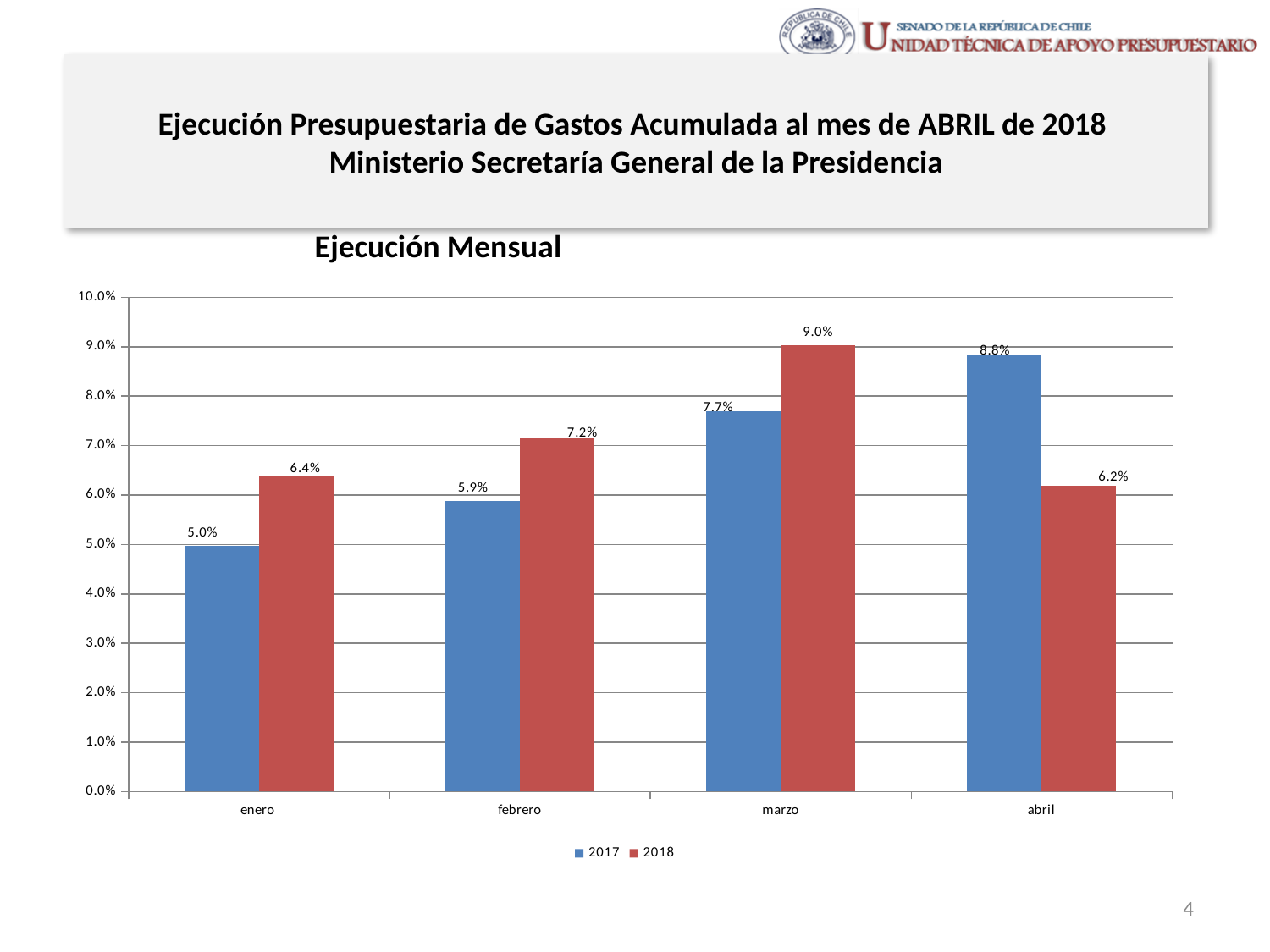
In which month is the 2017 value highest? abril What is the value for 2018 in abril? 6.2% What is the value for 2018 in marzo? 9.0% What is the difference between the 2018 and 2017 values in enero? 1.4% Which is larger in abril, the 2017 value or the 2018 value? 2017 What kind of chart is shown? bar chart Do the 2017 values rise or fall from enero to abril? rise What is the value for 2017 in enero? 5.0% How many months are shown on the x axis? 4 What is the value for 2017 in febrero? 5.9% In which month is the 2018 value lowest? abril How many series does the legend list? 2